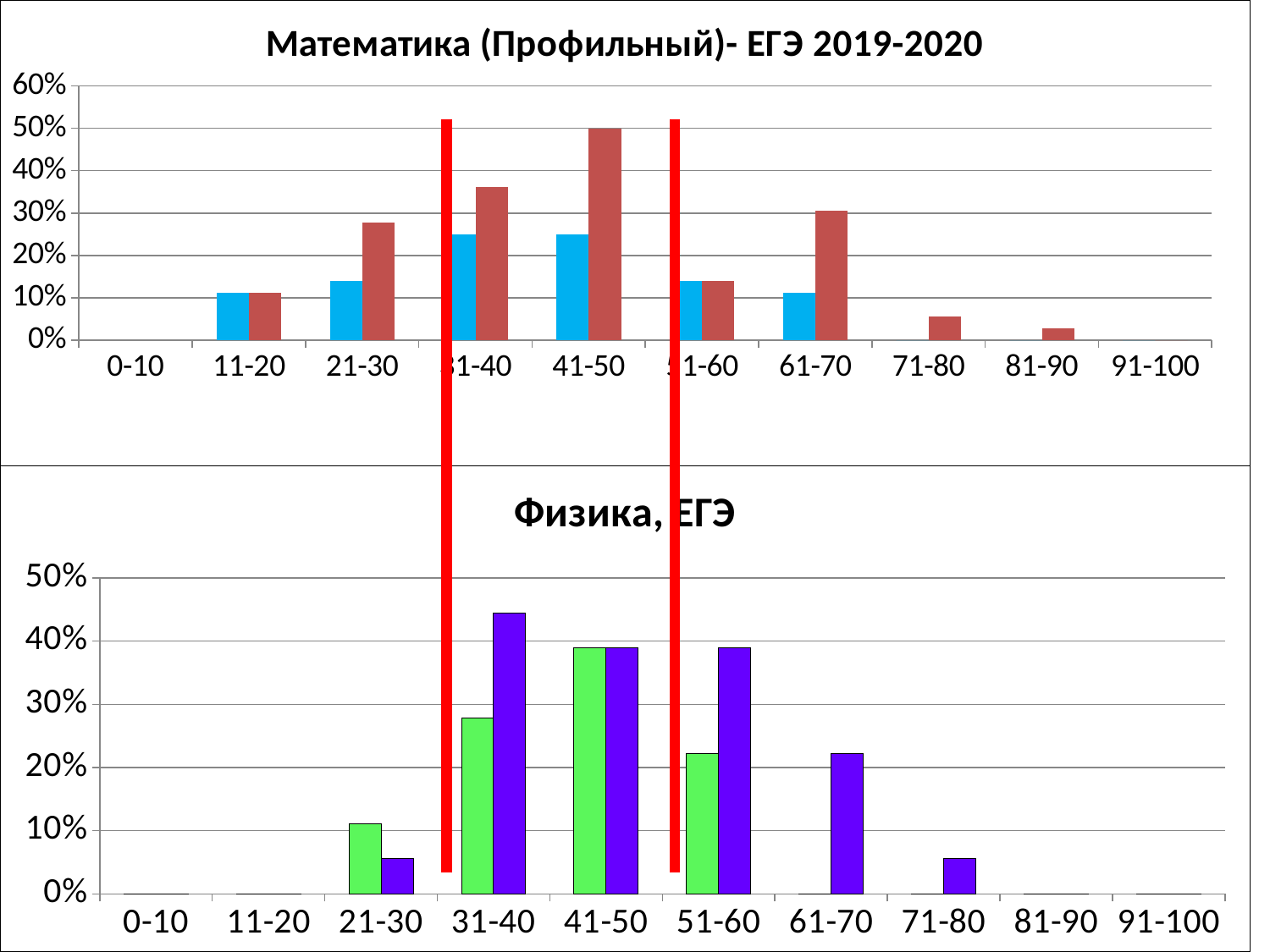
In the top chart (Математика), which score range has the tallest bar overall? 41-50 What is the title of the bottom chart? Физика, ЕГЭ In the top chart (Математика), for the 41-50 range, which bar is taller, the blue one or the brown one? The brown one In the top chart (Математика), is the brown bar for 41-50 greater or less than 40%? greater In the top chart (Математика), how many score-range categories are shown on the x axis? 10 In the top chart (Математика), is the blue bar for 11-20 greater or less than 20%? less In the top chart (Математика), is the brown bar for 81-90 greater or less than 10%? less In the bottom chart (Физика, ЕГЭ), for the 31-40 range, which bar is taller, the green one or the purple one? The purple one What type of chart is the top chart titled "Математика (Профильный)- ЕГЭ 2019-2020"? Bar chart In the bottom chart (Физика, ЕГЭ), which score range has the tallest bar overall? 31-40